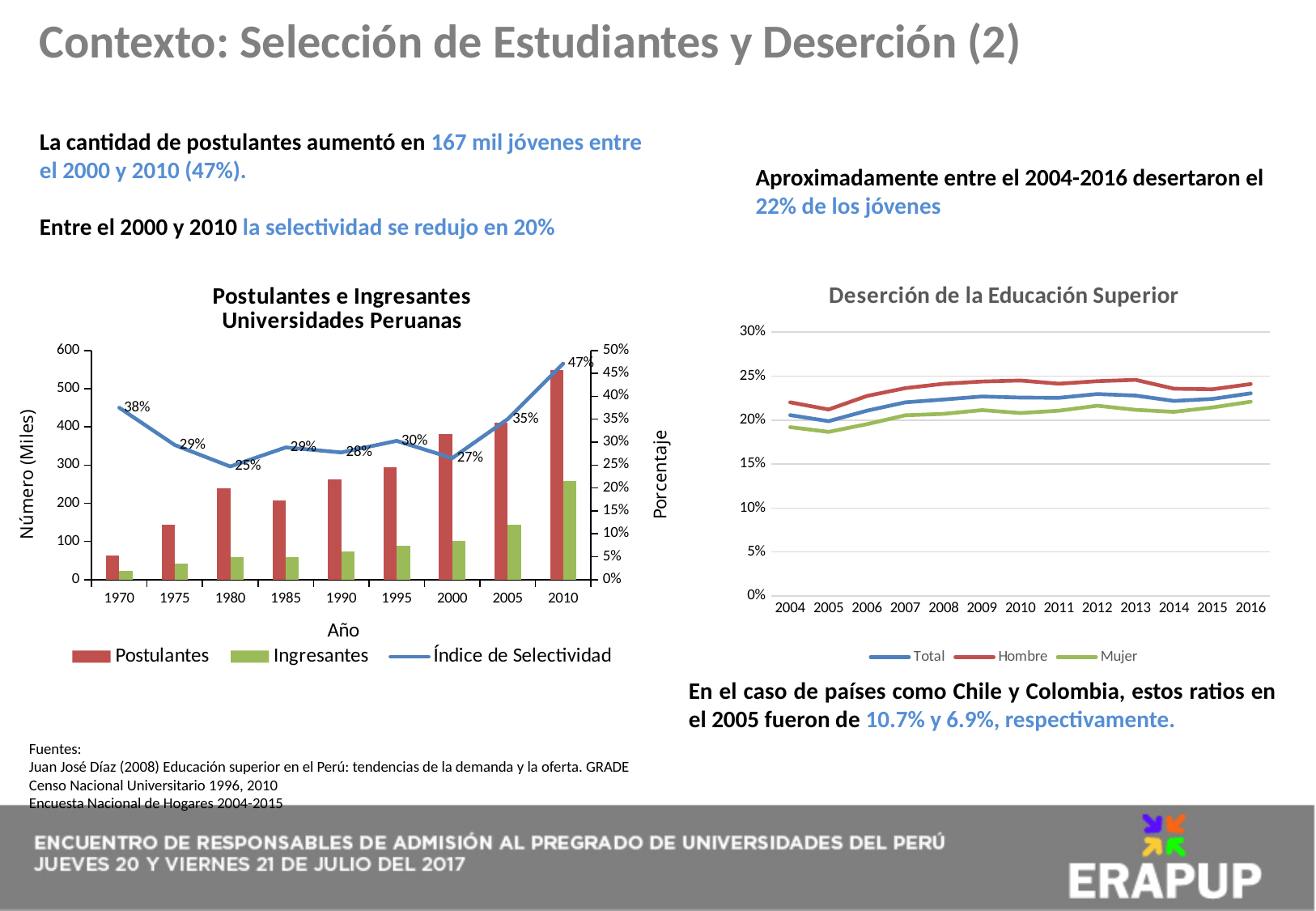
In the chart 'Deserción de la Educación Superior', which series has the highest value in 2016? Hombre In the chart 'Postulantes e Ingresantes Universidades Peruanas', which year has the lowest Índice de Selectividad? 1980 In the chart 'Postulantes e Ingresantes Universidades Peruanas', which year has the highest Índice de Selectividad? 2010 In the chart 'Postulantes e Ingresantes Universidades Peruanas', what is the Índice de Selectividad for 1970? 38% In the chart 'Deserción de la Educación Superior', how many series does the legend list? 3 In the chart 'Postulantes e Ingresantes Universidades Peruanas', what is the Índice de Selectividad for 2010? 47% In the chart 'Postulantes e Ingresantes Universidades Peruanas', is the value for Ingresantes in 2010 greater or less than 200? greater In the chart 'Postulantes e Ingresantes Universidades Peruanas', by how many percentage points does the Índice de Selectividad in 2010 exceed that of 2000? 20 percentage points In the chart 'Deserción de la Educación Superior', is the value for Mujer in 2005 greater or less than 20%? less In the chart 'Postulantes e Ingresantes Universidades Peruanas', is the value for Postulantes in 2010 greater or less than 500? greater In the chart 'Postulantes e Ingresantes Universidades Peruanas', how many years are shown on the x axis? 9 In the chart 'Postulantes e Ingresantes Universidades Peruanas', how many series does the legend list? 3